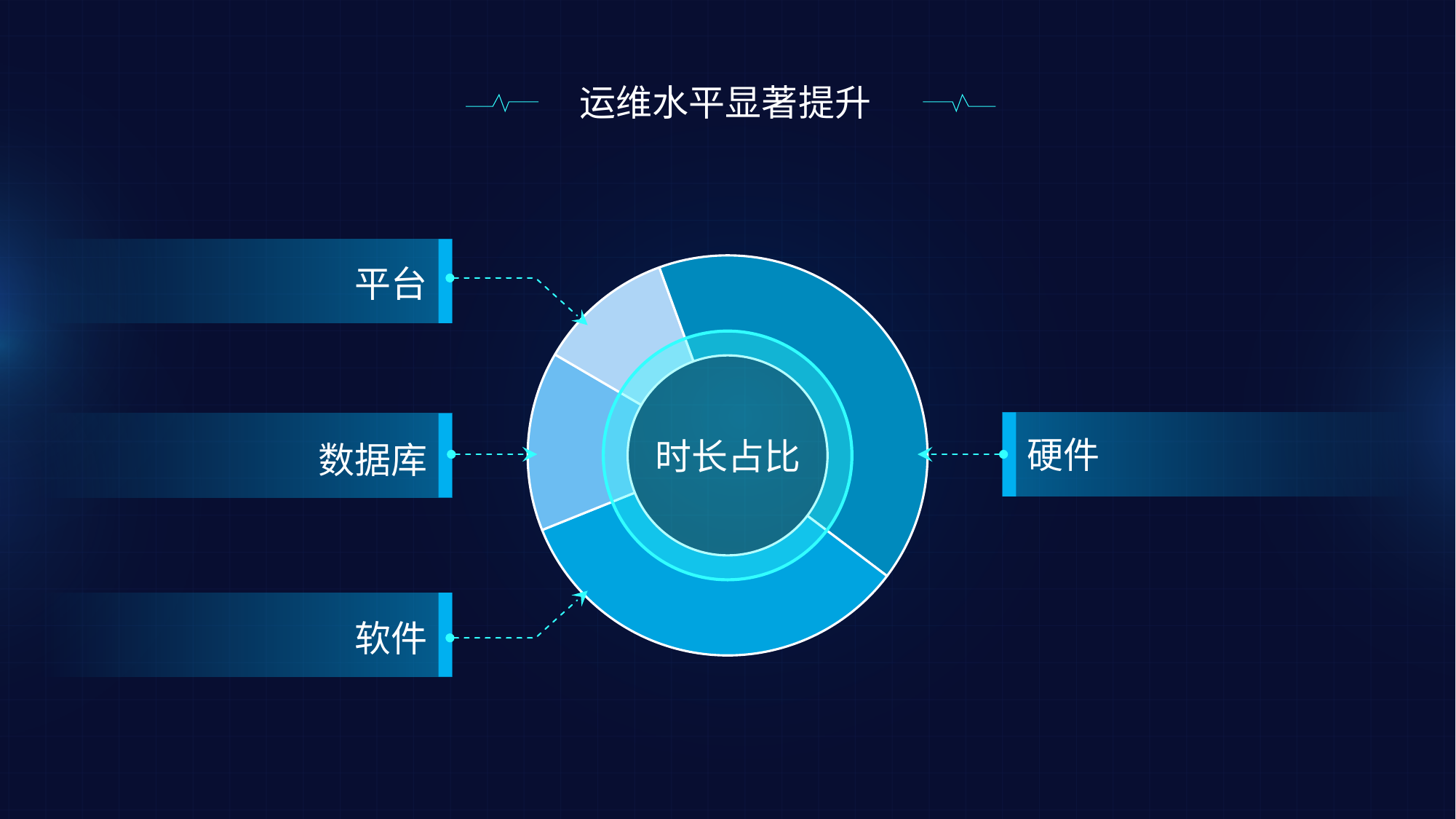
What text is shown in the centre of the pie chart? 时长占比 Which category has the largest share of the pie chart? 硬件 Which is larger in the pie chart, 硬件 or 平台? 硬件 Which is larger in the pie chart, 软件 or 数据库? 软件 What kind of chart is shown on the slide? doughnut chart What is the title of the slide containing the pie chart? 运维水平显著提升 Which is larger in the pie chart, 硬件 or 软件? 硬件 How many categories does the pie chart have? 4